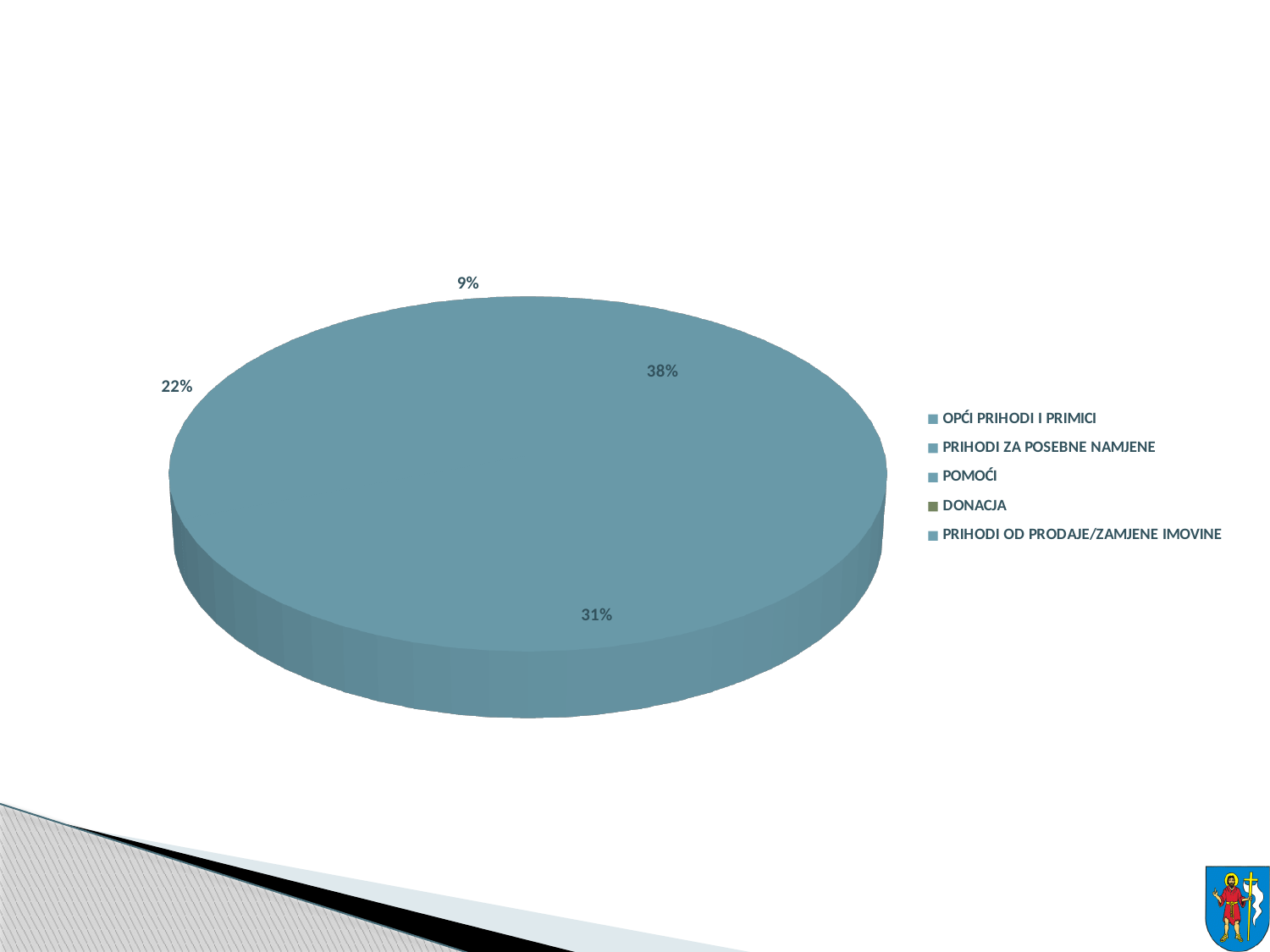
Which entry is listed first in the legend of the pie chart? OPĆI PRIHODI I PRIMICI What is the smallest percentage label shown on the pie chart? 9% What do the four printed percentage labels on the pie chart add up to? 100% What is the difference between the 38% slice and the 9% slice? 29 percentage points What is the difference between the 38% slice and the 31% slice? 7 percentage points What is the largest percentage label shown on the pie chart? 38% Which legend entry has a green marker instead of a blue one? DONACJA What kind of chart is shown on the slide? pie chart What is the difference between the 31% slice and the 22% slice? 9 percentage points Which is larger, the slice labelled 22% or the slice labelled 31%? 31% How many percentage labels are printed on the pie chart? 4 How many entries does the legend of the pie chart list? 5